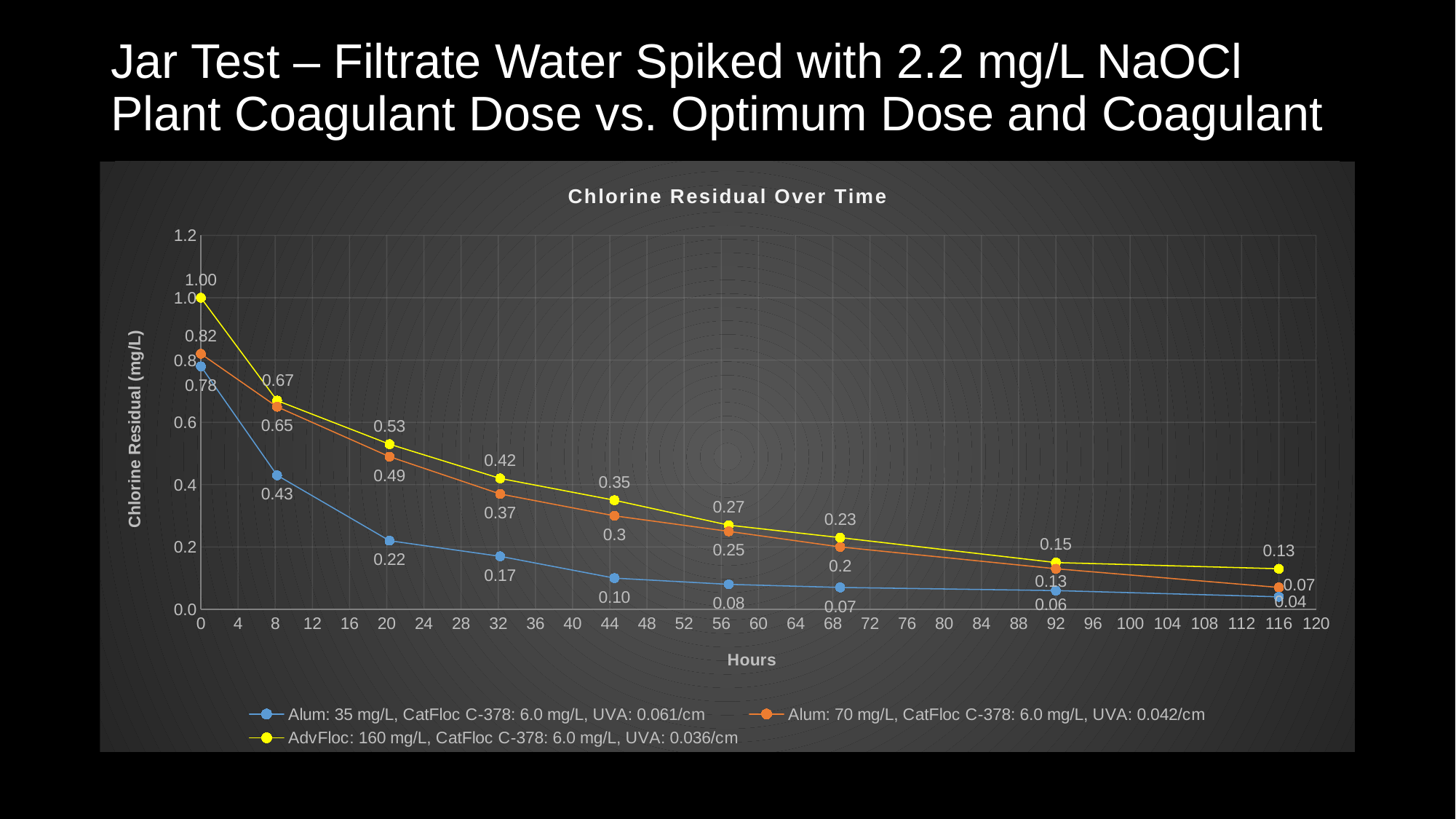
How many data points are plotted for each series? 9 Do the chlorine residual values rise or fall as hours increase? fall What is the final chlorine residual (last point, at 116 hours) for the Alum: 70 mg/L series? 0.07 What is the difference between the starting values (0 hours) of the AdvFloc: 160 mg/L series and the Alum: 70 mg/L series? 0.18 What is the starting chlorine residual (at 0 hours) for the Alum: 35 mg/L series? 0.78 At the last point (116 hours), which is larger: the Alum: 70 mg/L series or the Alum: 35 mg/L series? Alum: 70 mg/L, CatFloc C-378: 6.0 mg/L, UVA: 0.042/cm What kind of chart is shown on the slide? line chart How many series does the legend list? 3 Which series has the highest chlorine residual at the last point (116 hours)? AdvFloc: 160 mg/L, CatFloc C-378: 6.0 mg/L, UVA: 0.036/cm Which series has the lowest chlorine residual at 0 hours? Alum: 35 mg/L, CatFloc C-378: 6.0 mg/L, UVA: 0.061/cm What is the starting chlorine residual (at 0 hours) for the AdvFloc: 160 mg/L series? 1.00 What is the title of the chart? Chlorine Residual Over Time